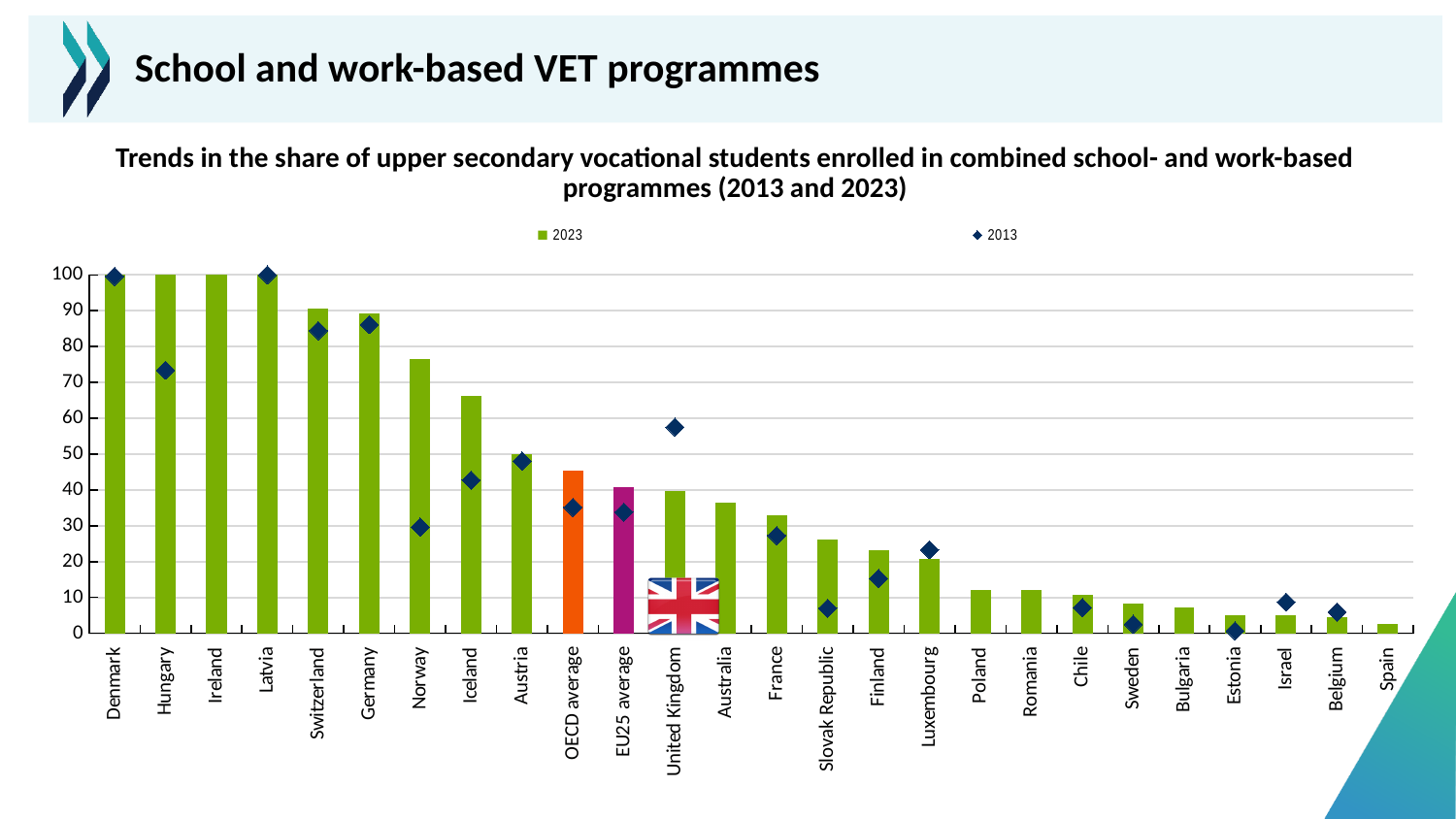
Which category has the lowest 2023 value? Spain How many series does the legend list? 2 How many countries or averages are shown along the x axis? 26 Is the 2023 value for Norway greater or less than 70? greater What kind of chart is shown on the slide? Bar chart What is the 2023 value for Denmark? 100 What is the 2023 value for Ireland? 100 Is the 2023 value for the OECD average greater or less than 40? greater Is the 2013 value for the United Kingdom greater or less than 50? greater Which category is shown with an orange bar? OECD average For the United Kingdom, which is larger: the 2013 value or the 2023 value? 2013 Do the 2023 values rise or fall moving from left to right along the x axis? Fall